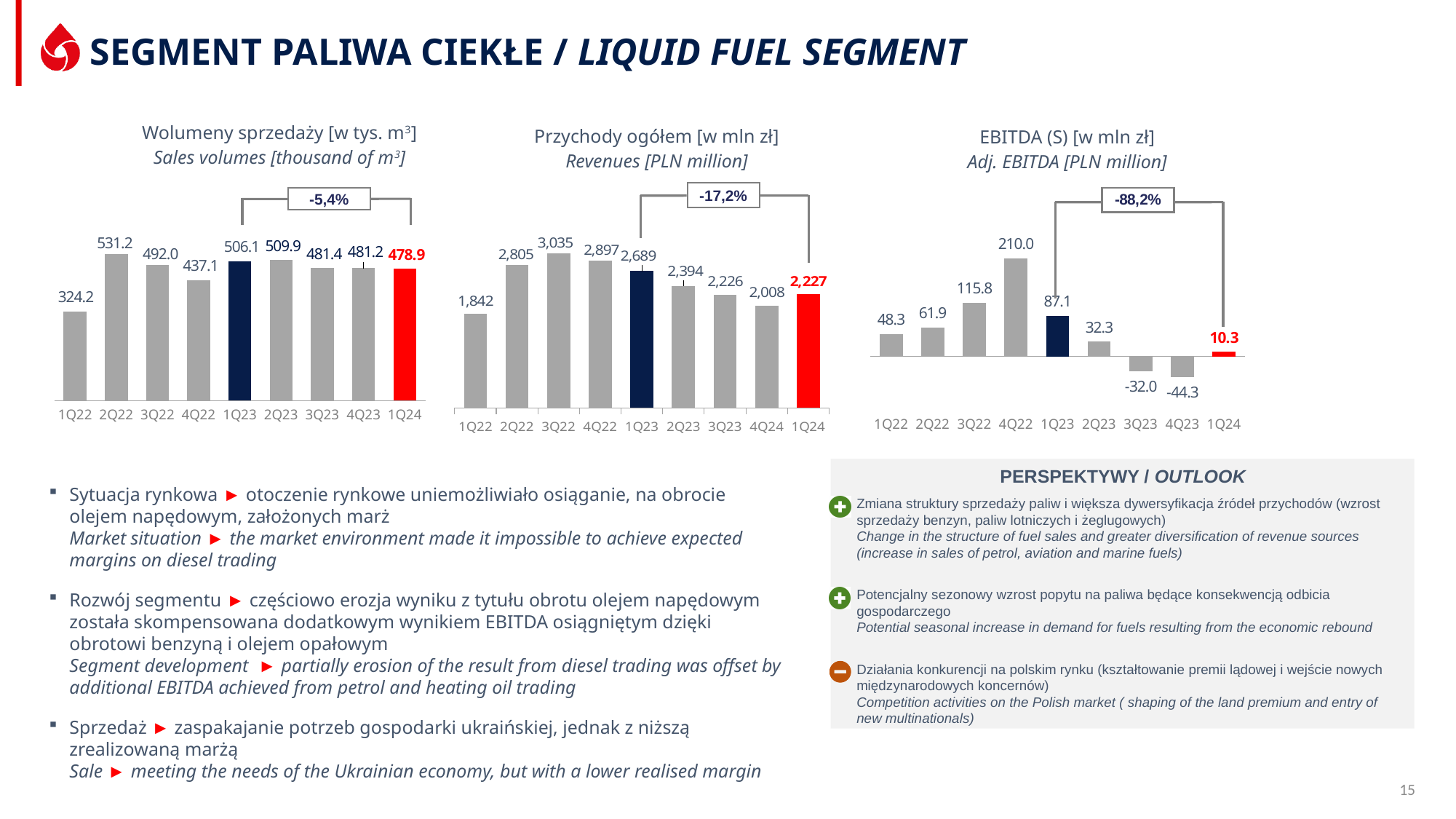
How many quarters are shown in the Sales volumes chart? 9 In the Adj. EBITDA chart, which is larger, the value for 1Q23 or the value for 2Q23? 1Q23 In the Sales volumes chart, what is the difference between 1Q23 and 1Q24? 27.2 In the Adj. EBITDA chart, what is the difference between 4Q22 and 1Q23? 122.9 In the Revenues chart, what percentage change is shown between 1Q23 and 1Q24? -17,2% What type of chart is the Revenues chart? Bar chart In the Sales volumes chart, which quarter has the highest value? 2Q22 In the Revenues chart, what is the value for 3Q22? 3,035 In the Adj. EBITDA chart, which quarter has the lowest value? 4Q23 In the Sales volumes chart, what is the value for 1Q24? 478.9 In the Adj. EBITDA chart, what is the value for 4Q22? 210.0 In the Revenues chart, which quarter has the lowest value? 1Q22